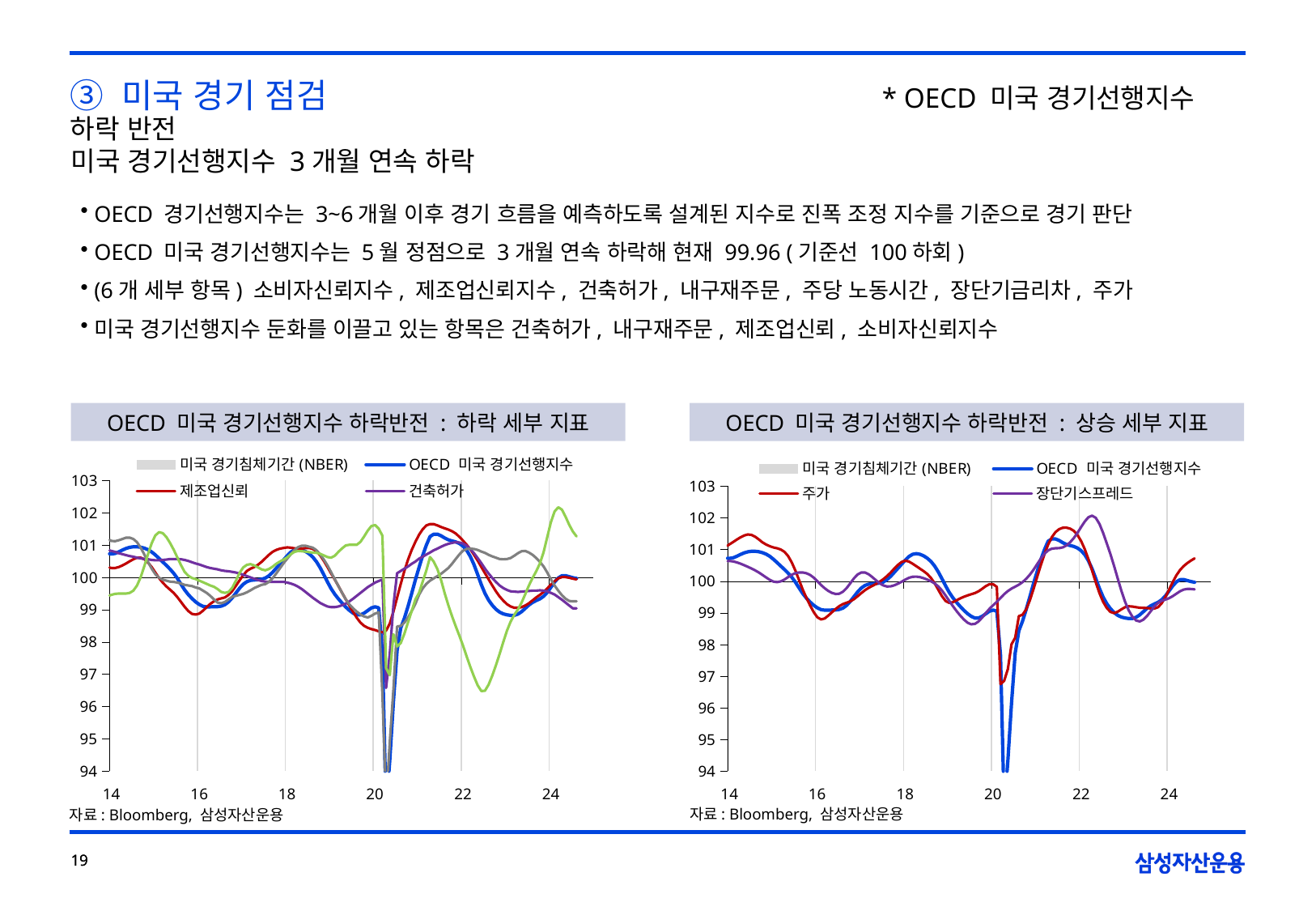
In the right chart, is the lowest value of 주가 around 2020 greater or less than 98? less In the right chart, how many entries does the legend list? 4 In the left chart, is the peak value of 제조업신뢰 around 2021 greater or less than 101? greater In the right chart, does OECD 미국 경기선행지수 rise or fall between its 2020 low and 2021? rise What kind of chart is the left chart titled 'OECD 미국 경기선행지수 하락반전 : 하락 세부 지표'? line chart In the right chart, is the peak value of 장단기스프레드 around 2022 greater or less than 101? greater In the left chart, how many entries does the legend list? 4 In the right chart, which legend entry is drawn in purple? 장단기스프레드 What kind of chart is the right chart titled 'OECD 미국 경기선행지수 하락반전 : 상승 세부 지표'? line chart In the left chart, which legend entry is drawn in dark red? 제조업신뢰 How many year labels are shown on the x axis of the right chart? 6